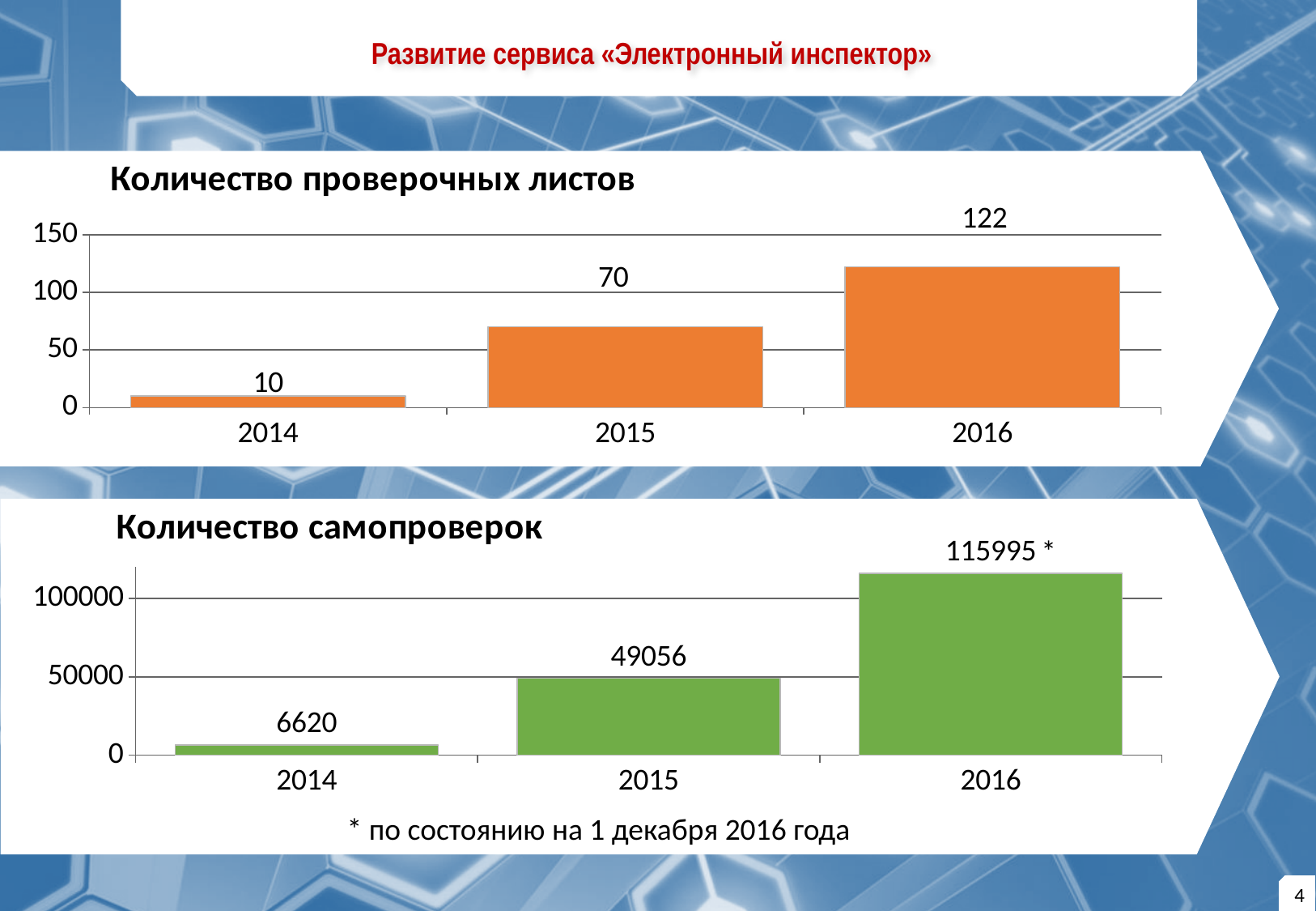
In the chart titled "Количество самопроверок", which year has the highest value? 2016 In the chart titled "Количество проверочных листов", which year has the lowest value? 2014 What type of chart is the chart titled "Количество самопроверок"? bar chart In the chart titled "Количество проверочных листов", what is the difference between the values for 2016 and 2015? 52 In the chart titled "Количество самопроверок", what is the value for 2014? 6620 In the chart titled "Количество самопроверок", what is the difference between the values for 2015 and 2014? 42436 In the chart titled "Количество проверочных листов", do the values rise or fall from 2014 to 2016? rise In the chart titled "Количество самопроверок", what is the value for 2015? 49056 In the chart titled "Количество проверочных листов", what is the value for 2015? 70 In the chart titled "Количество проверочных листов", how many years are shown on the x axis? 3 In the chart titled "Количество самопроверок", is the value for 2016 greater or less than 100000? greater In the chart titled "Количество проверочных листов", what is the value for 2016? 122